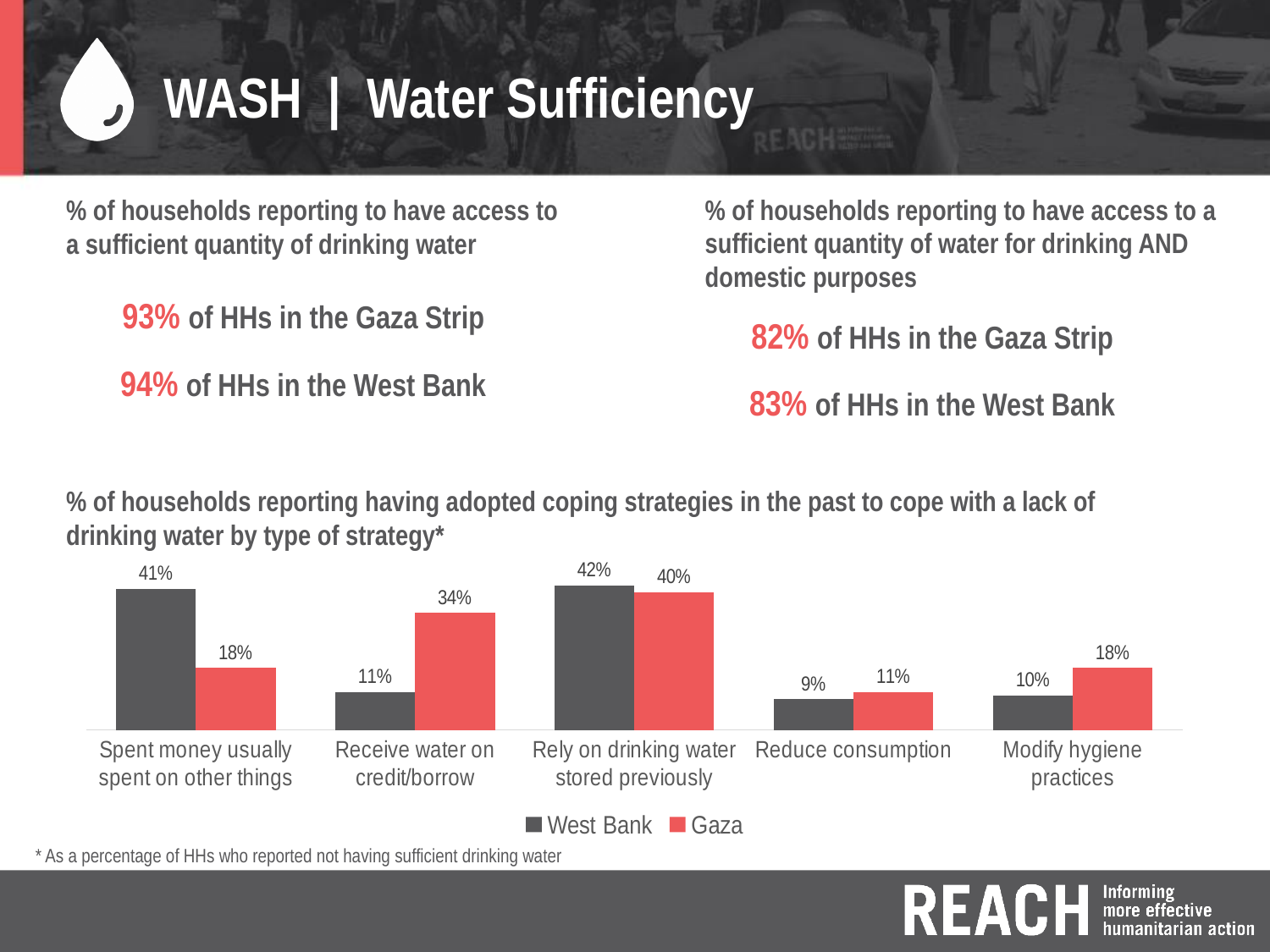
What kind of chart is used to show the coping strategies? Bar chart What is the difference between the Gaza and West Bank values for 'Modify hygiene practices'? 8 percentage points For 'Receive water on credit/borrow', which is larger: the West Bank value or the Gaza value? Gaza What percentage of Gaza households reported relying on drinking water stored previously? 40% What percentage of West Bank households reported spending money usually spent on other things as a coping strategy? 41% Which coping strategy has the highest value for West Bank? Rely on drinking water stored previously Which coping strategy has the lowest value for West Bank? Reduce consumption What is the difference between the West Bank and Gaza values for 'Spent money usually spent on other things'? 23 percentage points How many series does the chart legend list? 2 How many coping strategy categories are shown on the x axis of the chart? 5 What percentage of Gaza households reported receiving water on credit/borrow? 34% Which colour represents Gaza in the chart? Red